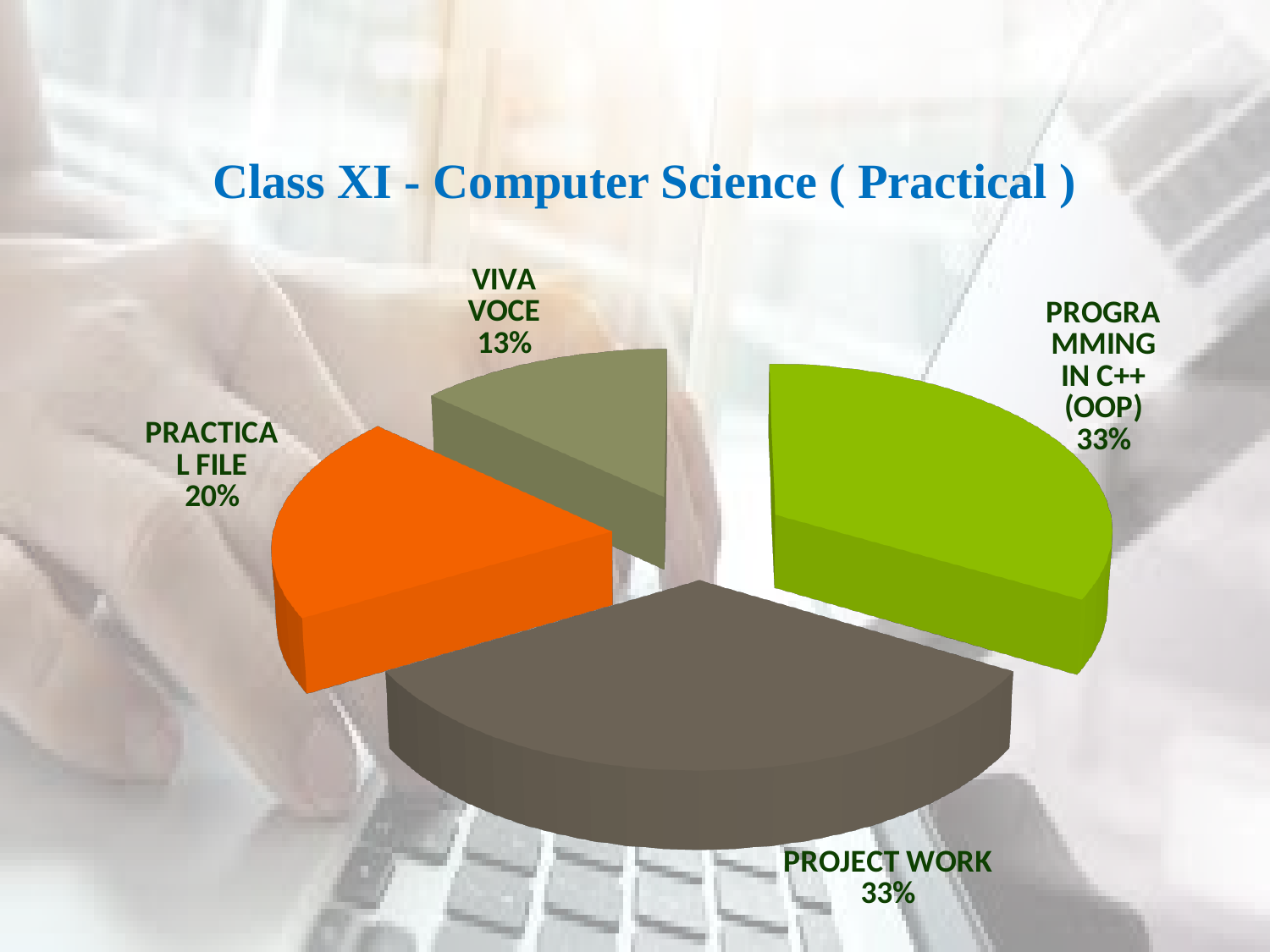
Which two components have the same share of the pie? Programming in C++ (OOP) and Project Work Which component has the smallest share of the pie? Viva Voce How many slices does the pie chart have? 4 What colour is the Practical File slice? Orange Which is larger, the share for Practical File or the share for Viva Voce? Practical File What is the title of the slide? Class XI - Computer Science ( Practical ) What percentage does the Practical File slice represent? 20% By how many percentage points does Practical File exceed Viva Voce? 7 percentage points What percentage does the Programming in C++ (OOP) slice represent? 33% What percentage does the Project Work slice represent? 33% What percentage does the Viva Voce slice represent? 13% What kind of chart is shown on the slide? Pie chart